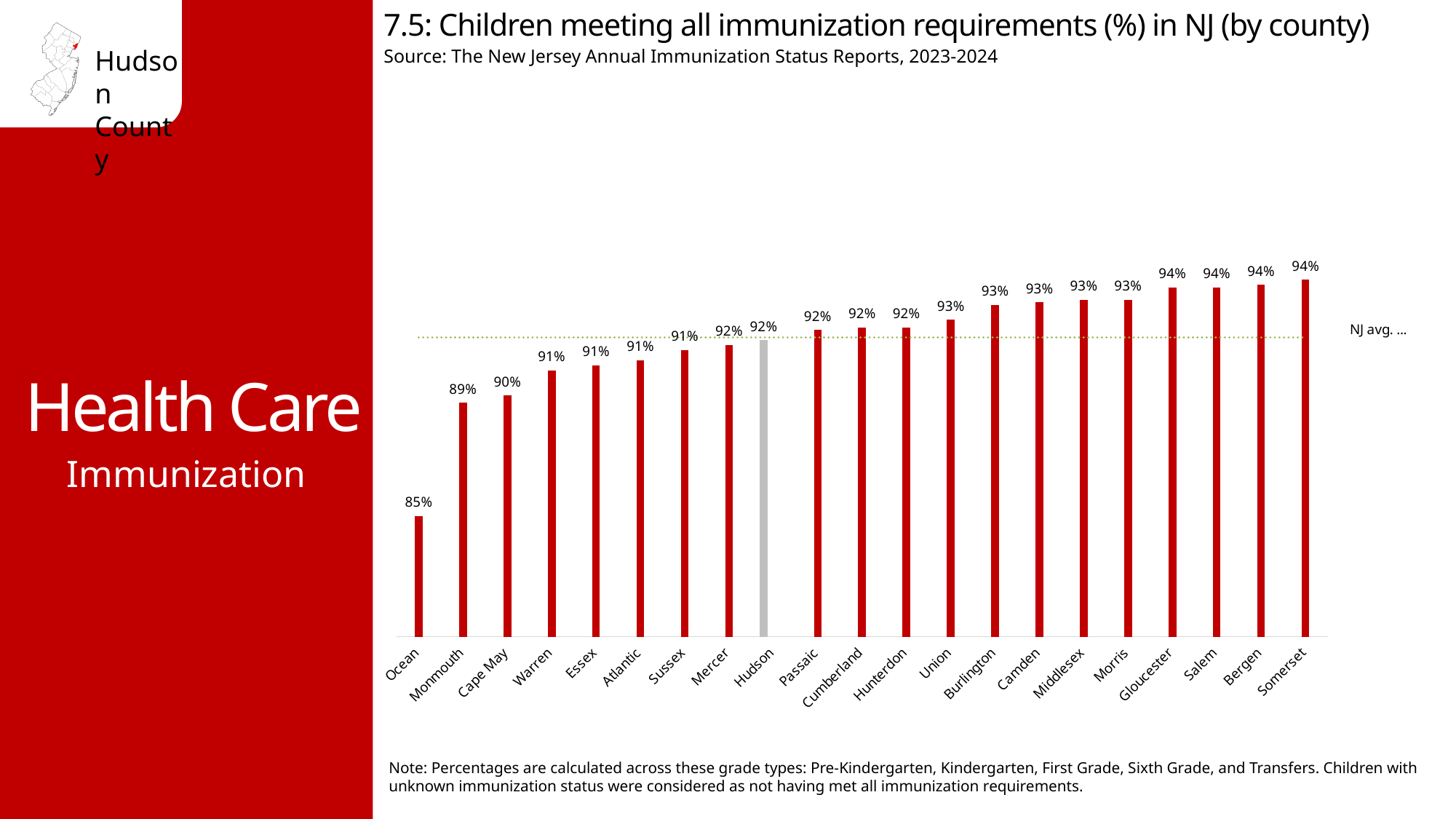
What is the value for Cape May? 90% What is the source cited for the chart? The New Jersey Annual Immunization Status Reports, 2023-2024 Which county has the lowest value? Ocean What is the value for Ocean? 85% What is the value for Morris? 93% What is the difference between the values for Somerset and Ocean? 9 percentage points Do the values generally rise or fall from left to right along the x axis? Rise What is the value for Hudson? 92% What kind of chart is shown on the slide? Bar chart How many counties are shown on the chart? 21 Which county's bar is coloured grey instead of red? Hudson Which is larger, the value for Monmouth or the value for Ocean? Monmouth